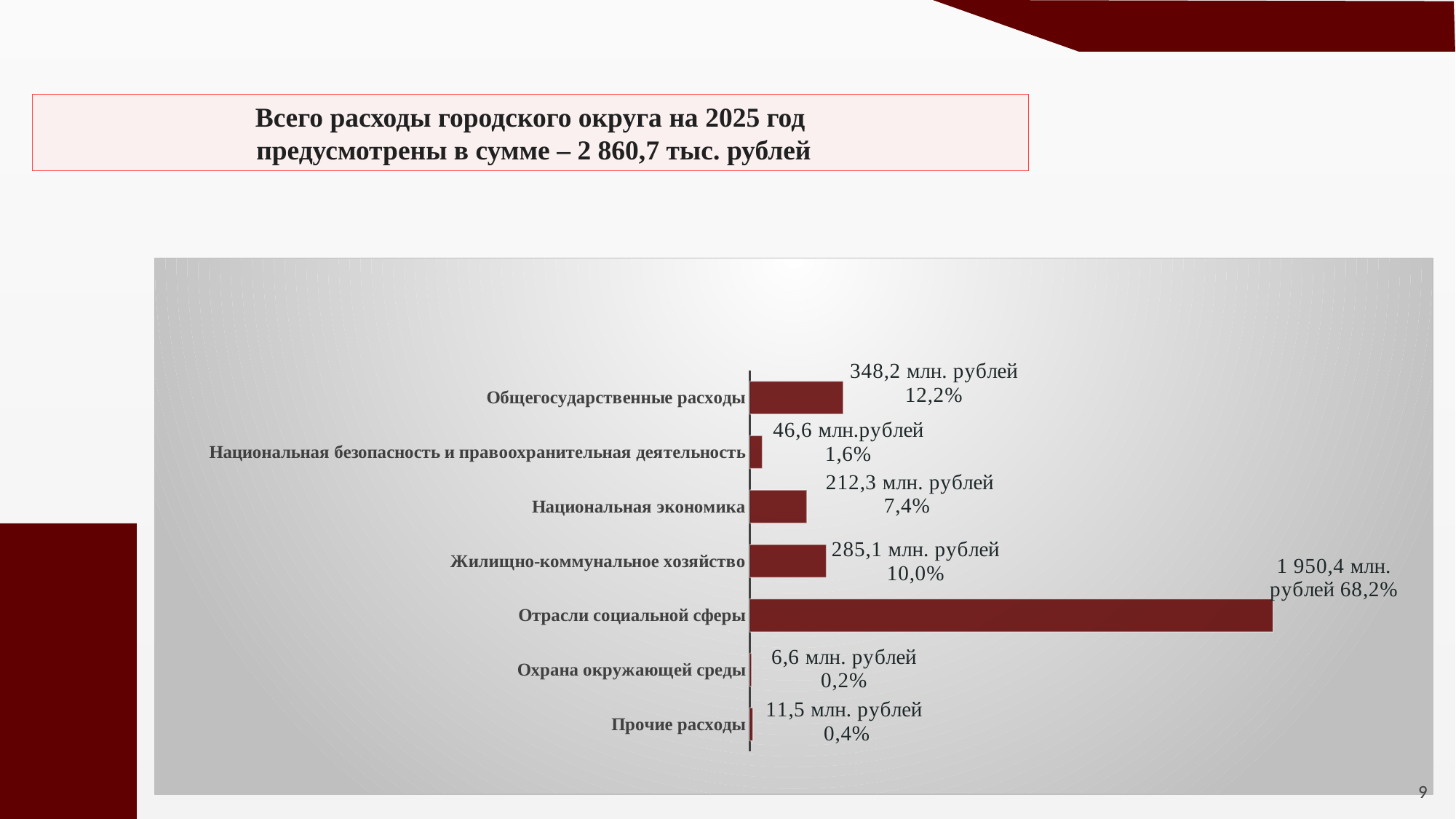
What kind of chart is shown on the slide? Bar chart Which is larger, Национальная экономика or Жилищно-коммунальное хозяйство? Жилищно-коммунальное хозяйство What value is shown for Общегосударственные расходы? 348,2 млн. рублей Which category has the highest value? Отрасли социальной сферы What is the difference in млн. рублей between Прочие расходы and Охрана окружающей среды? 4,9 млн. рублей According to the slide heading, what is the total expenditure of the city district for 2025? 2 860,7 тыс. рублей What is the difference in млн. рублей between Общегосударственные расходы and Жилищно-коммунальное хозяйство? 63,1 млн. рублей Which category has the lowest value? Охрана окружающей среды What share of expenditures is shown for Отрасли социальной сферы? 68,2% What percentage is shown for Национальная безопасность и правоохранительная деятельность? 1,6% How many categories are shown in the chart? 7 What value is shown for Жилищно-коммунальное хозяйство? 285,1 млн. рублей